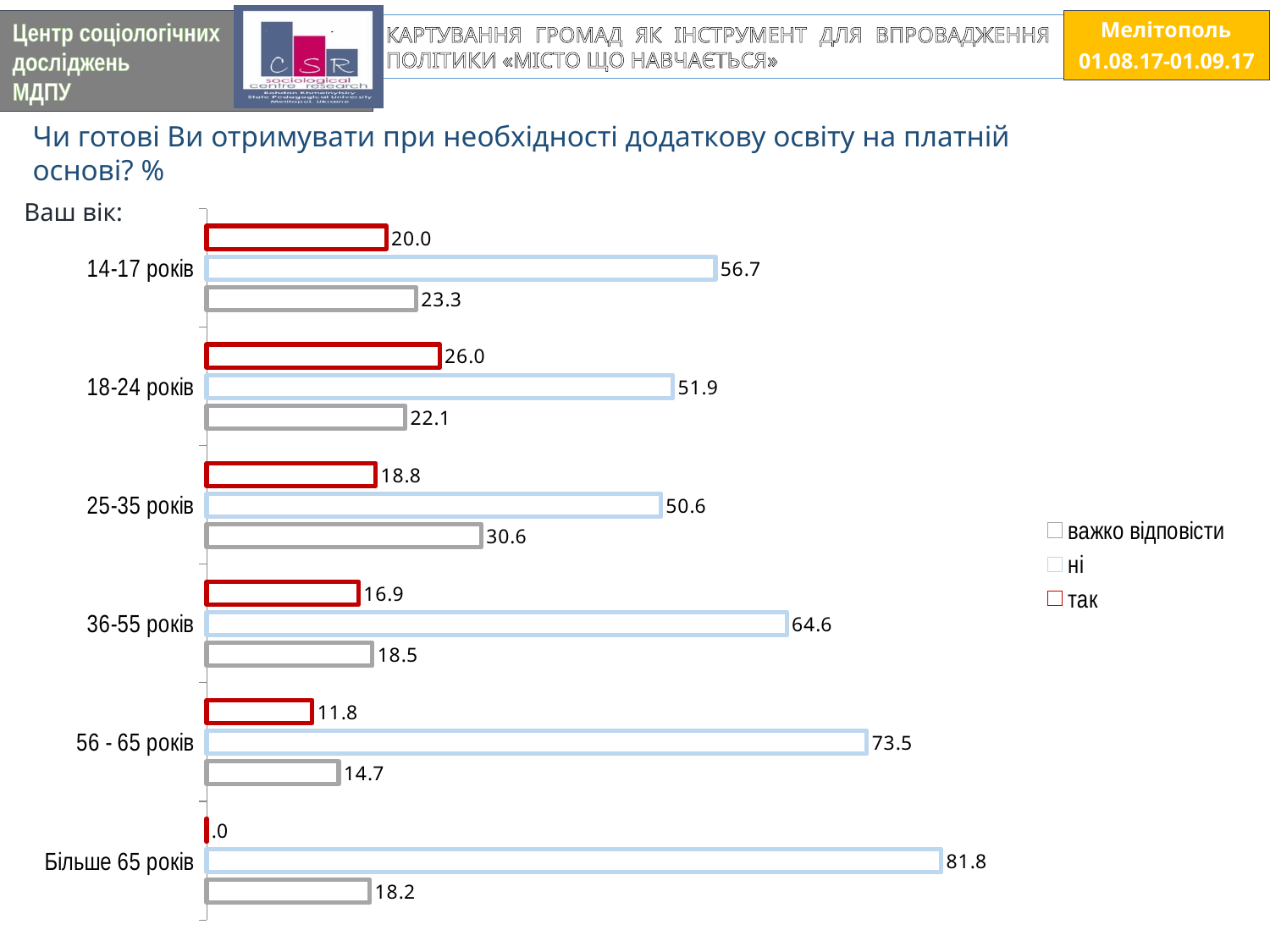
What kind of chart is shown on the slide? bar chart What is the total of the three values for the 56 - 65 років age group? 100.0 Which age group has the lowest value for "так"? Більше 65 років What is the value for "ні" in the 56 - 65 років age group? 73.5 Which colour represents the "так" series in the legend? red How many series does the legend list? 3 How many age groups are shown on the chart? 6 What is the difference between the "ні" values for 36-55 років and 14-17 років? 7.9 Which is larger: the "так" value for 14-17 років or for 25-35 років? 14-17 років What is the value for "важко відповісти" in the 25-35 років age group? 30.6 Which age group has the highest value for "ні"? Більше 65 років What is the value for "так" in the 18-24 років age group? 26.0